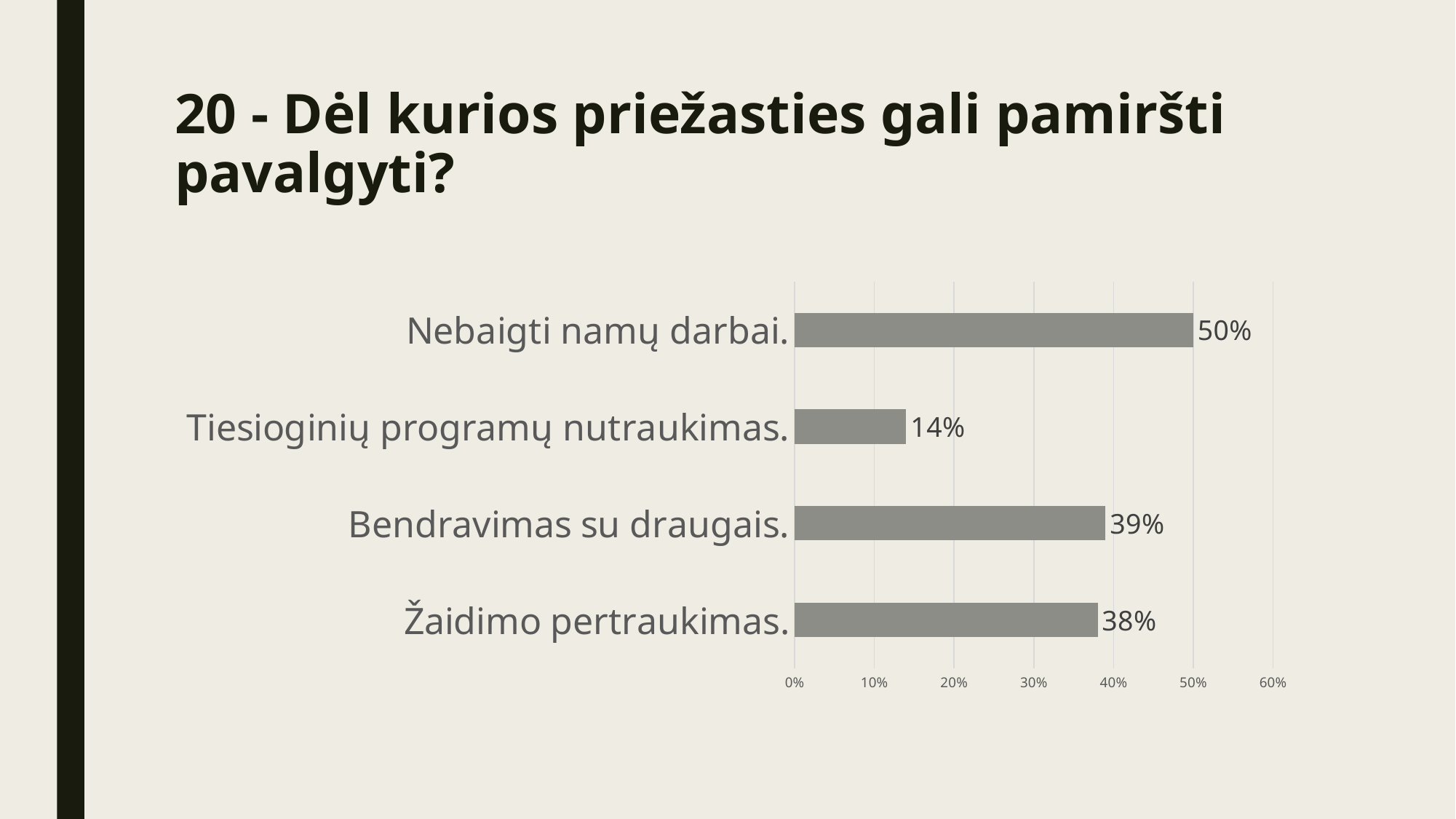
What is the value for "Tiesioginių programų nutraukimas."? 14% What is the value for "Žaidimo pertraukimas."? 38% What is the difference between the values for "Bendravimas su draugais." and "Žaidimo pertraukimas."? 1% What is the difference between the values for "Nebaigti namų darbai." and "Tiesioginių programų nutraukimas."? 36% Which category has the lowest value? Tiesioginių programų nutraukimas. Which category has the highest value? Nebaigti namų darbai. What is the value for "Bendravimas su draugais."? 39% What is the value for "Nebaigti namų darbai."? 50% How many categories are shown in the chart? 4 What kind of chart is shown on the slide? bar chart Is the value for "Žaidimo pertraukimas." greater or less than 30%? greater Which is larger: the value for "Nebaigti namų darbai." or the value for "Bendravimas su draugais."? Nebaigti namų darbai.